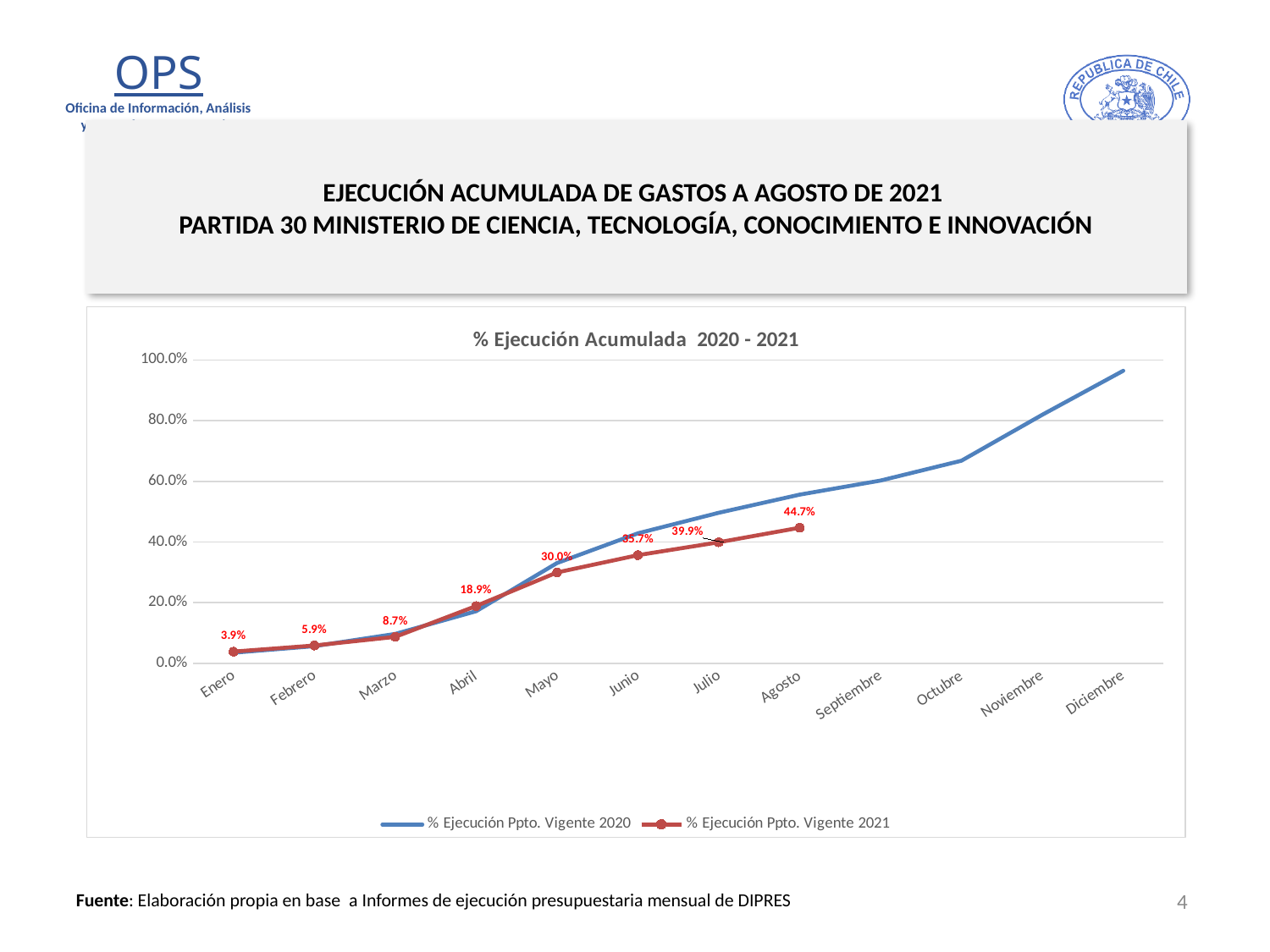
Which month has the highest value for % Ejecución Ppto. Vigente 2021? Agosto What type of chart is shown on the slide? Line chart How many series does the legend list? 2 Is the value of % Ejecución Ppto. Vigente 2020 for Diciembre greater or less than 80.0%? greater What is the value of % Ejecución Ppto. Vigente 2021 for Enero? 3.9% Does the % Ejecución Ppto. Vigente 2020 line rise or fall from Enero to Diciembre? Rise What is the value of % Ejecución Ppto. Vigente 2021 for Agosto? 44.7% What is the value of % Ejecución Ppto. Vigente 2021 for Abril? 18.9% What is the value of % Ejecución Ppto. Vigente 2021 for Mayo? 30.0% What is the chart's title? % Ejecución Acumulada 2020 - 2021 What is the difference between the 2021 values for Agosto and Julio? 4.8% What is the difference between the 2021 values for Mayo and Abril? 11.1%